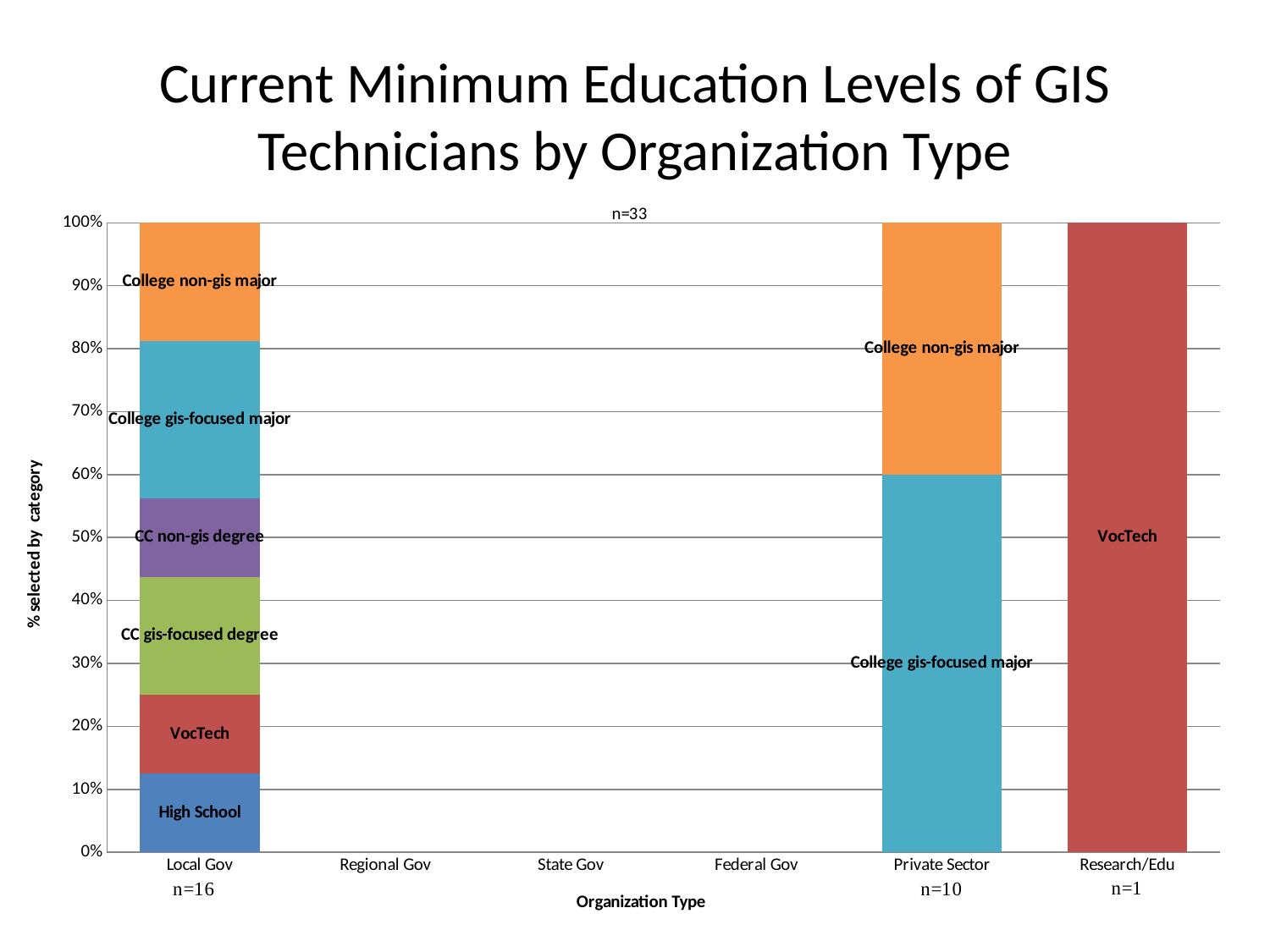
In the Private Sector bar, which segment is larger: College gis-focused major or College non-gis major? College gis-focused major What percentage of the Research/Edu bar is VocTech? 100% What is the title of the chart? Current Minimum Education Levels of GIS Technicians by Organization Type Is the High School segment of the Local Gov bar greater or less than 20%? less Which organization type's bar consists of a single education level? Research/Edu How many organization types have a bar plotted in the chart? 3 How many organization types are listed along the x axis? 6 What kind of chart is shown on the slide? Stacked bar chart What percentage of the Private Sector bar is College non-gis major? 40% What percentage of the Private Sector bar is College gis-focused major? 60% What is the sample size (n) for Local Gov? n=16 How many education-level segments make up the Local Gov bar? 6